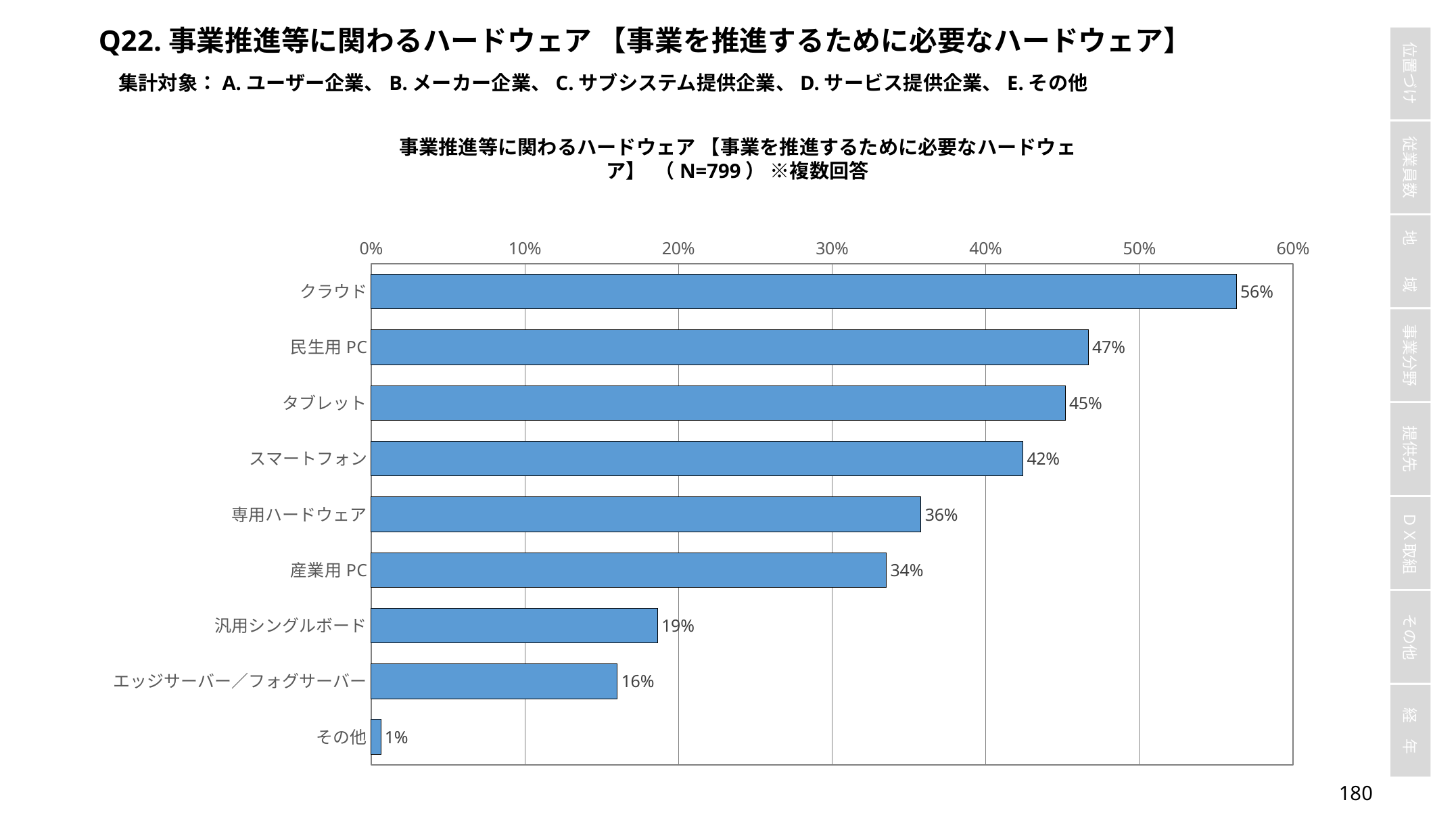
What kind of chart is shown on the slide? bar chart What is the N (number of respondents) stated in the chart title? N=799 Which category has the lowest value? その他 What is the value for 産業用PC? 34% What is the value for エッジサーバー／フォグサーバー? 16% What is the value for クラウド? 56% How many categories are shown in the chart? 9 What is the difference between the values for クラウド and 汎用シングルボード? 37% Which is larger, the value for スマートフォン or the value for 専用ハードウェア? スマートフォン What is the difference between the values for 民生用PC and タブレット? 2% Is the value for 産業用PC greater or less than 30%? greater Which category has the highest value? クラウド